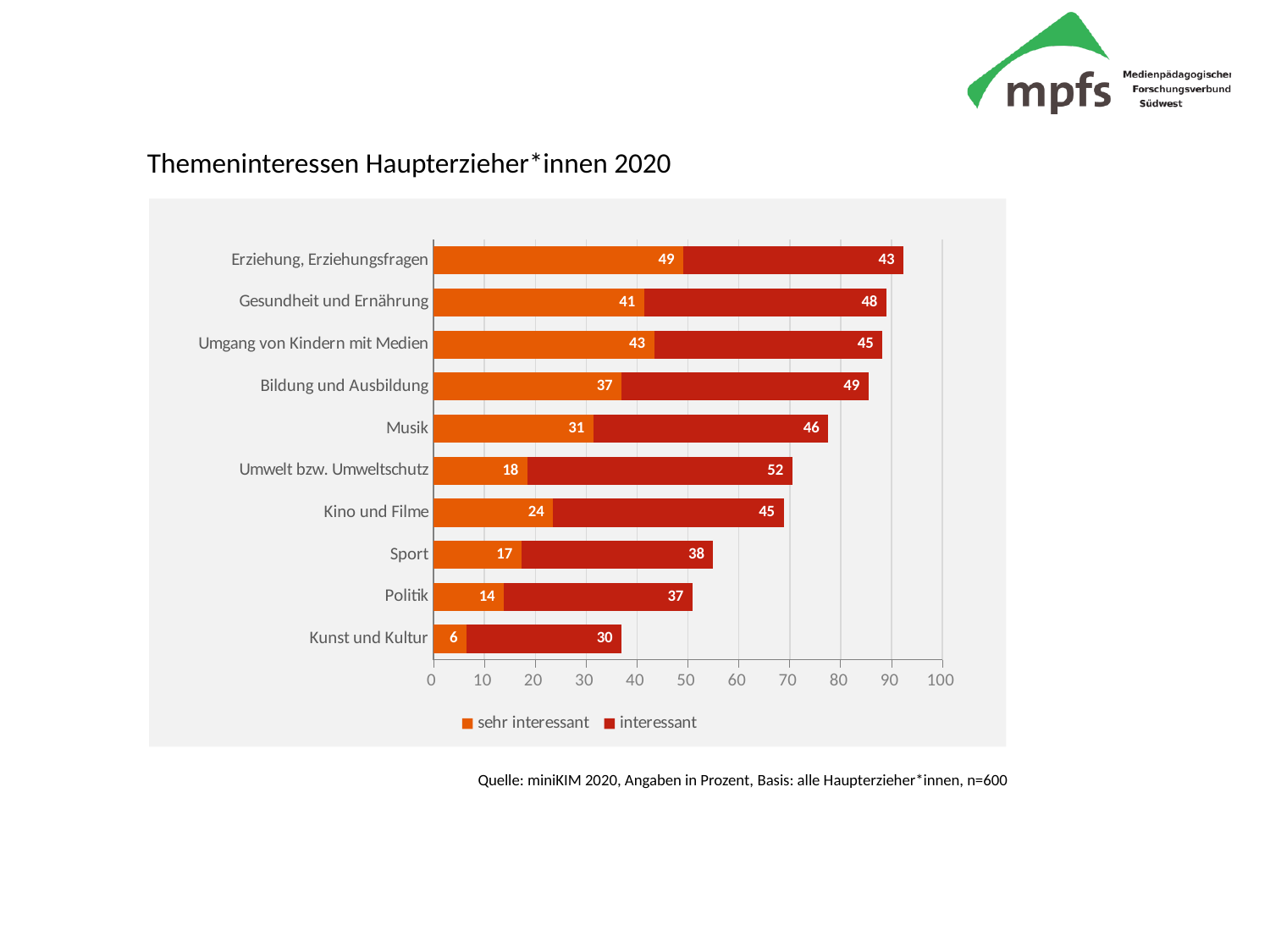
Which category has the highest 'sehr interessant' value? Erziehung, Erziehungsfragen Which category has the lowest 'interessant' value? Kunst und Kultur What is the 'sehr interessant' value for Erziehung, Erziehungsfragen? 49 Which is larger: the 'sehr interessant' value for Musik or for Kino und Filme? Musik What is the 'interessant' value for Umwelt bzw. Umweltschutz? 52 What kind of chart is shown on the slide? Stacked bar chart What is the difference between the 'interessant' values for Bildung und Ausbildung and Politik? 12 What is the total of the stacked bar for Gesundheit und Ernährung? 89 What is the total of the stacked bar for Sport? 55 How many categories are shown in the chart? 10 How many series does the legend list? 2 What is the 'sehr interessant' value for Kunst und Kultur? 6